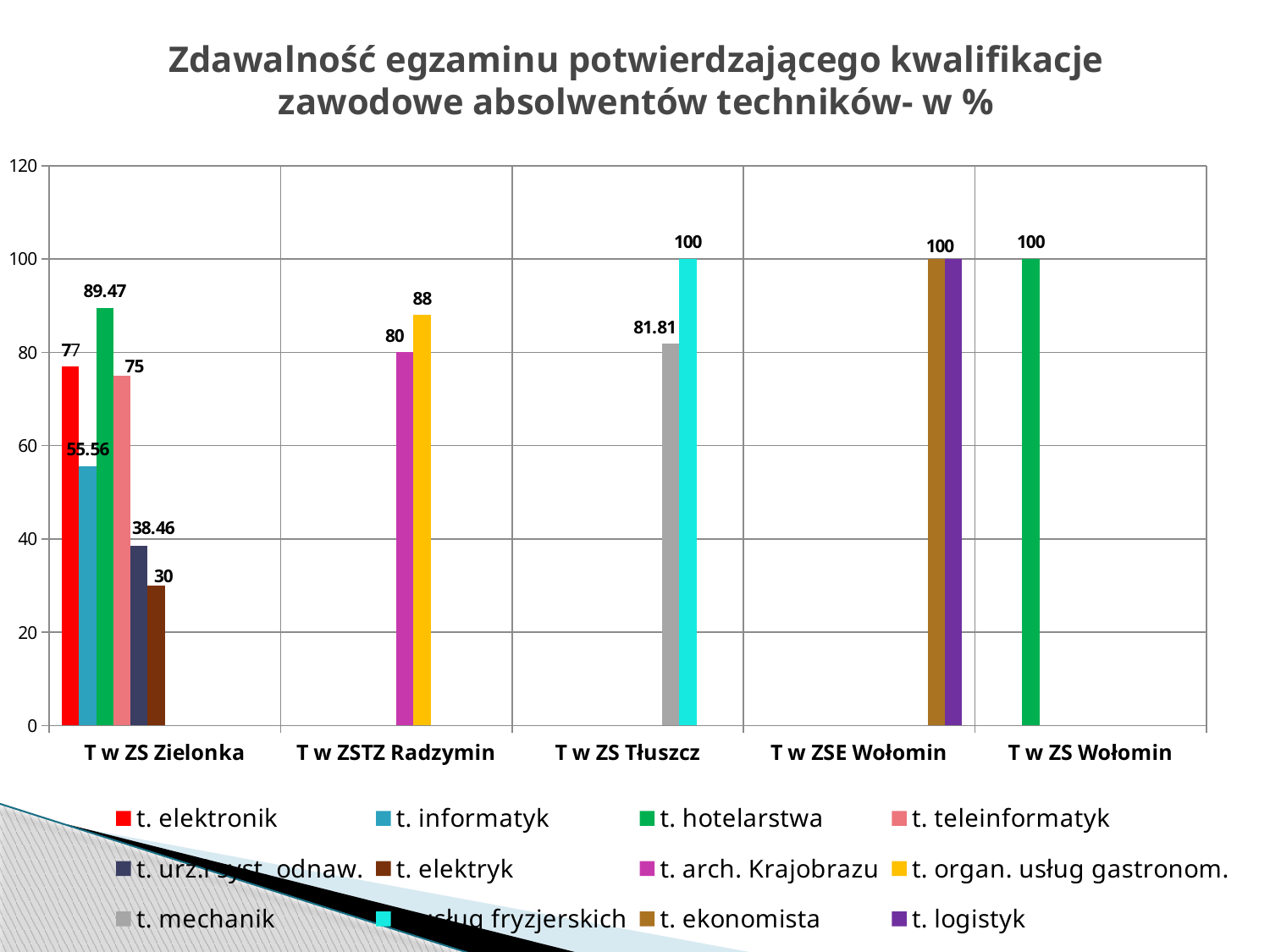
How many series does the legend list? 12 What is the difference between t. elektronik and t. elektryk at T w ZS Zielonka? 47 What is the value for t. hotelarstwa at T w ZS Zielonka? 89.47 Which series has the lowest value at T w ZS Zielonka? t. elektryk Which series has the highest value at T w ZS Zielonka? t. hotelarstwa What is the value for t. informatyk at T w ZS Zielonka? 55.56 What is the value for t. organ. usług gastronom. at T w ZSTZ Radzymin? 88 How many school categories are shown on the x axis? 5 Is the value for t. urz. i syst. odnaw. at T w ZS Zielonka greater or less than 40? less Which is larger at T w ZSTZ Radzymin: t. arch. Krajobrazu or t. organ. usług gastronom.? t. organ. usług gastronom. What kind of chart is shown on the slide? bar chart What is the value for t. mechanik at T w ZS Tłuszcz? 81.81